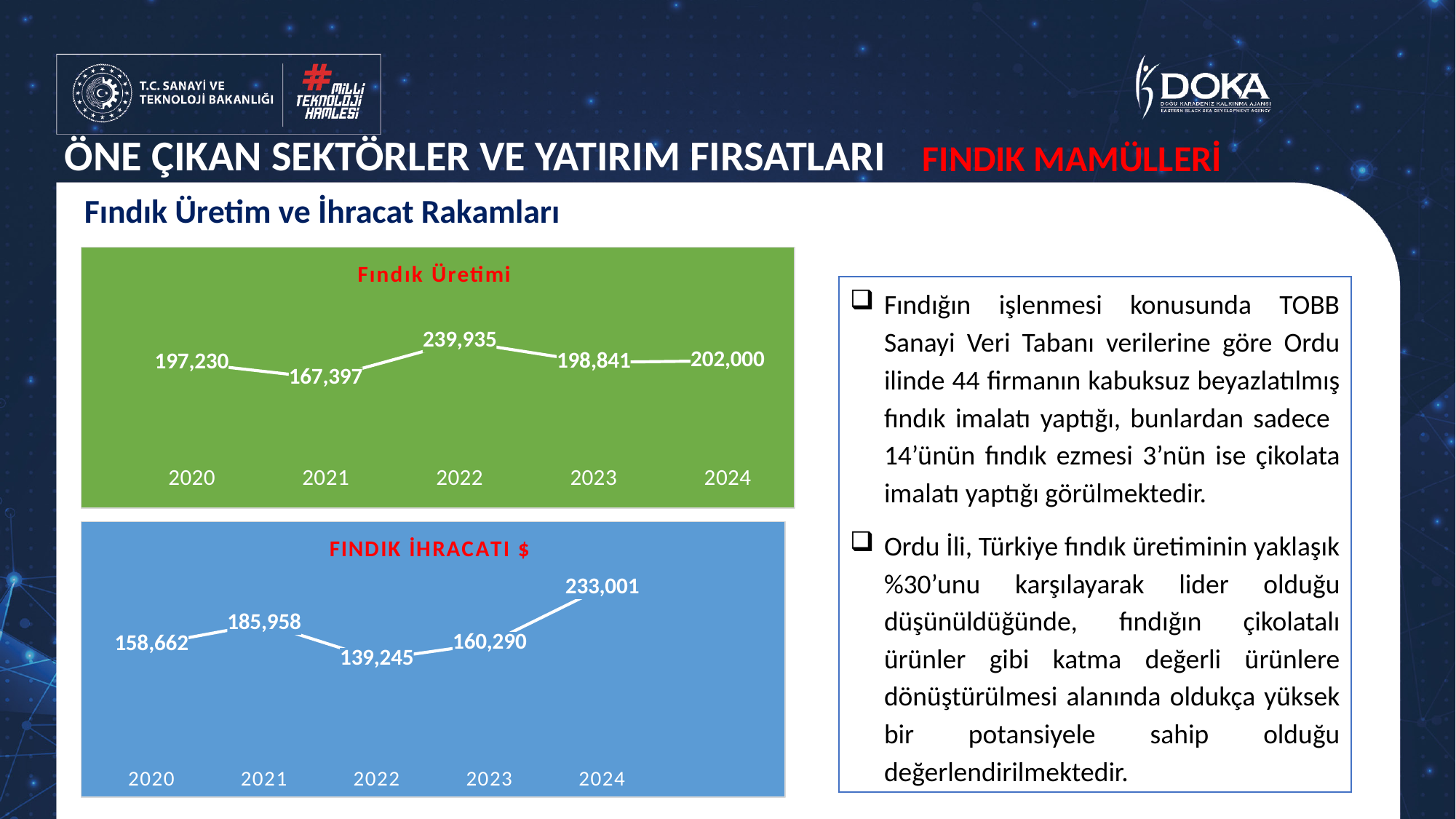
In the 'Fındık Üretimi' chart, what is the value for 2021? 167,397 In the 'Fındık Üretimi' chart, what is the difference between the 2022 and 2021 values? 72,538 In the 'FINDIK İHRACATI $' chart, which is larger, the value for 2021 or the value for 2023? 2021 In the 'FINDIK İHRACATI $' chart, what is the difference between the 2024 and 2023 values? 72,711 In the 'Fındık Üretimi' chart, what is the value for 2022? 239,935 In the 'FINDIK İHRACATI $' chart, which year has the lowest value? 2022 In the 'Fındık Üretimi' chart, which year has the lowest value? 2021 In the 'Fındık Üretimi' chart, which year has the highest value? 2022 In the 'FINDIK İHRACATI $' chart, what is the value for 2024? 233,001 What type of chart is the 'FINDIK İHRACATI $' chart? Line chart In the 'FINDIK İHRACATI $' chart, what is the value for 2022? 139,245 In the 'Fındık Üretimi' chart, how many years are plotted? 5